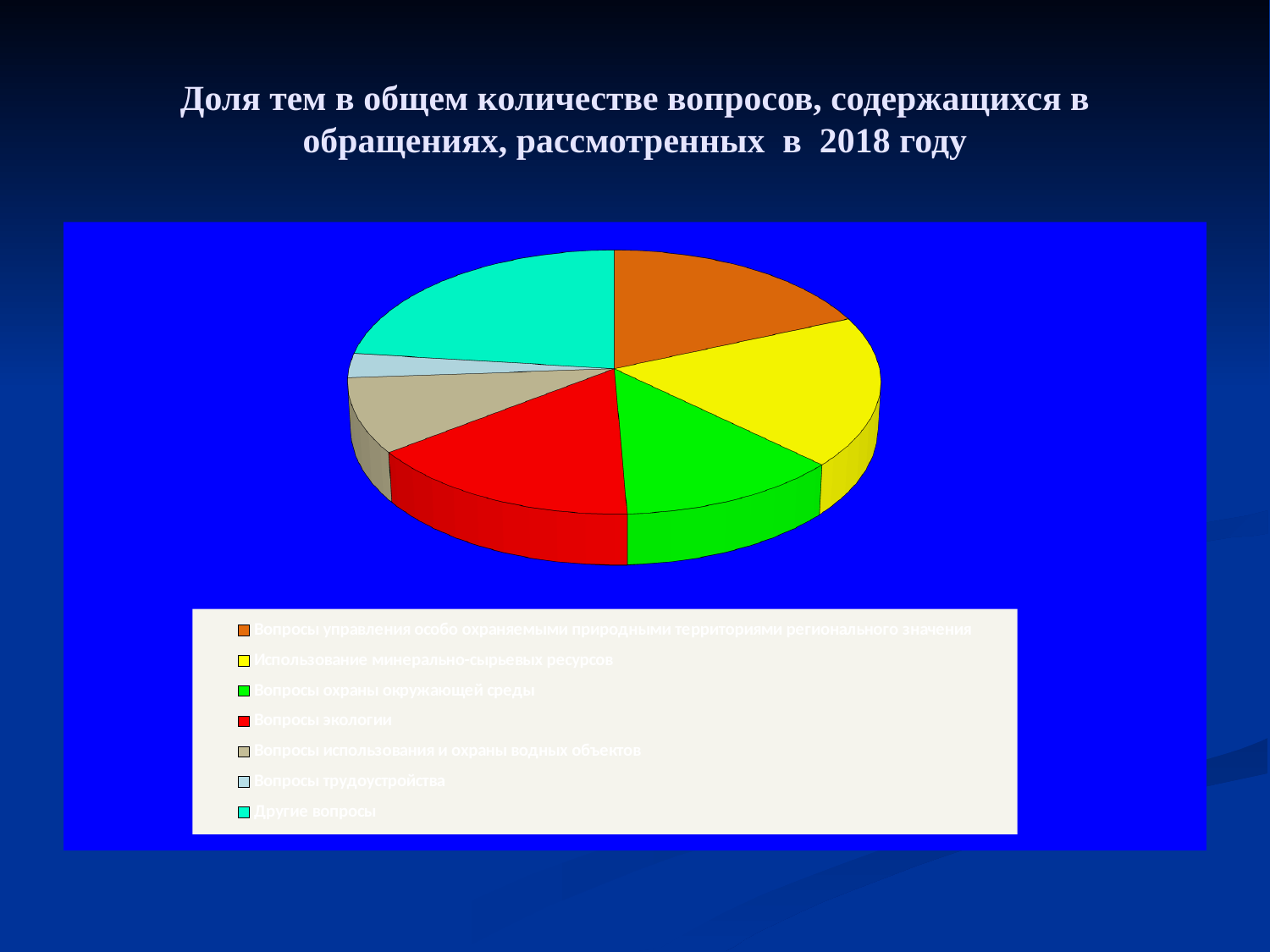
How many slices does the pie chart have? 7 What kind of chart is shown on the slide? Pie chart Which slice is larger: "Использование минерально-сырьевых ресурсов" or "Вопросы использования и охраны водных объектов"? Использование минерально-сырьевых ресурсов Which slice is larger: "Вопросы экологии" or "Вопросы трудоустройства"? Вопросы экологии Which slice is larger: "Другие вопросы" or "Вопросы использования и охраны водных объектов"? Другие вопросы What is the title of the chart on the slide? Доля тем в общем количестве вопросов, содержащихся в обращениях, рассмотренных в 2018 году What colour represents "Вопросы экологии" in the pie chart? Red How many entries does the legend list? 7 Which category has the smallest slice in the pie chart? Вопросы трудоустройства